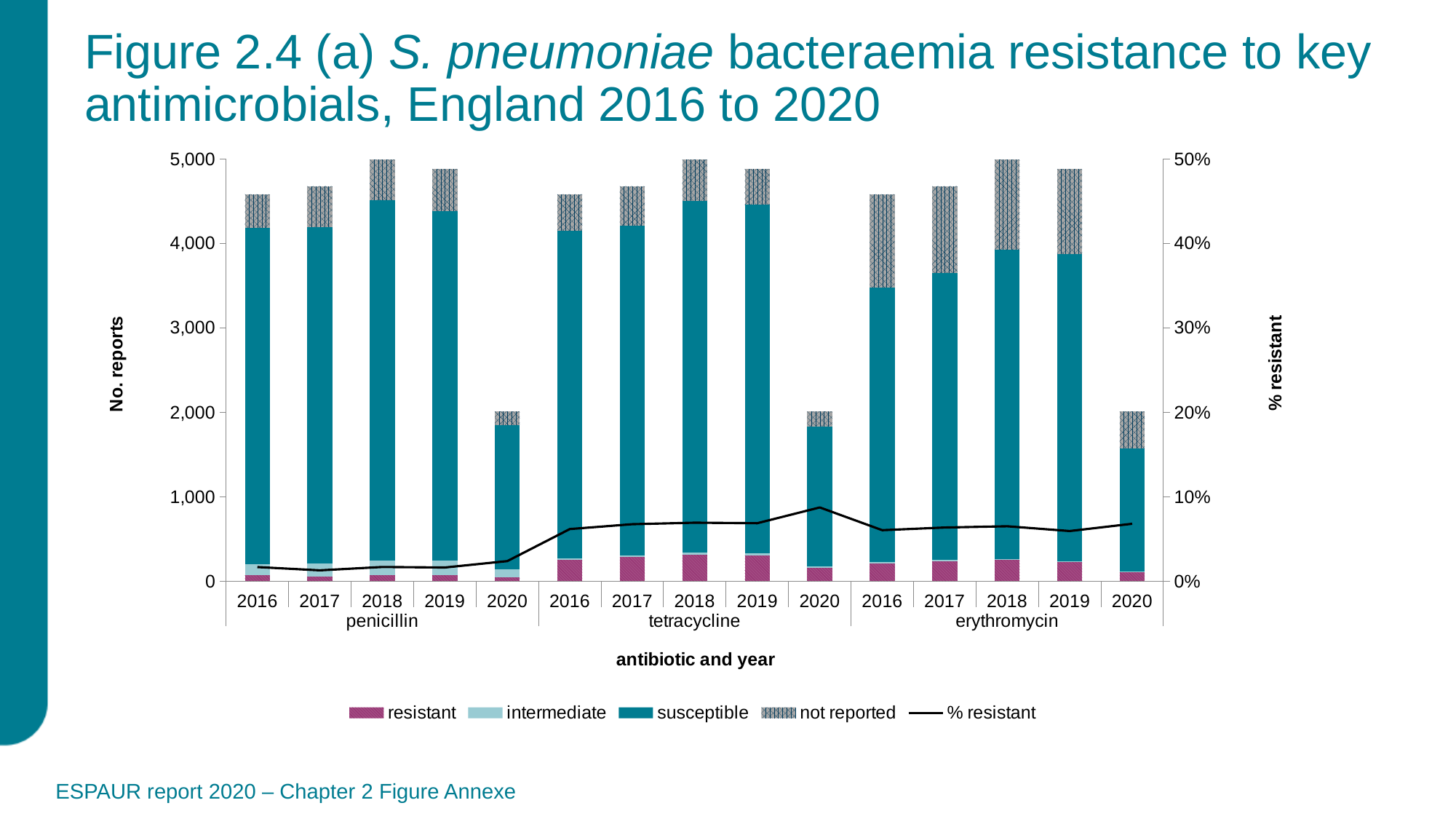
Is the total number of reports for tetracycline in 2018 greater or less than 4,000? greater Which is larger, the not reported segment for erythromycin in 2018 or for penicillin in 2018? erythromycin 2018 How many antibiotics are shown along the x axis? 3 For which antibiotic and year does the % resistant line reach its highest point? tetracycline 2020 Which year has the lowest total number of reports for erythromycin? 2020 What kind of chart is shown on the slide? stacked bar chart with a line Is the % resistant value for penicillin in 2016 greater or less than 5%? less How many bars are plotted in the chart? 15 How many series does the legend list? 5 Is the total number of reports for penicillin in 2020 greater or less than 3,000? less What is the title of the left vertical axis? No. reports